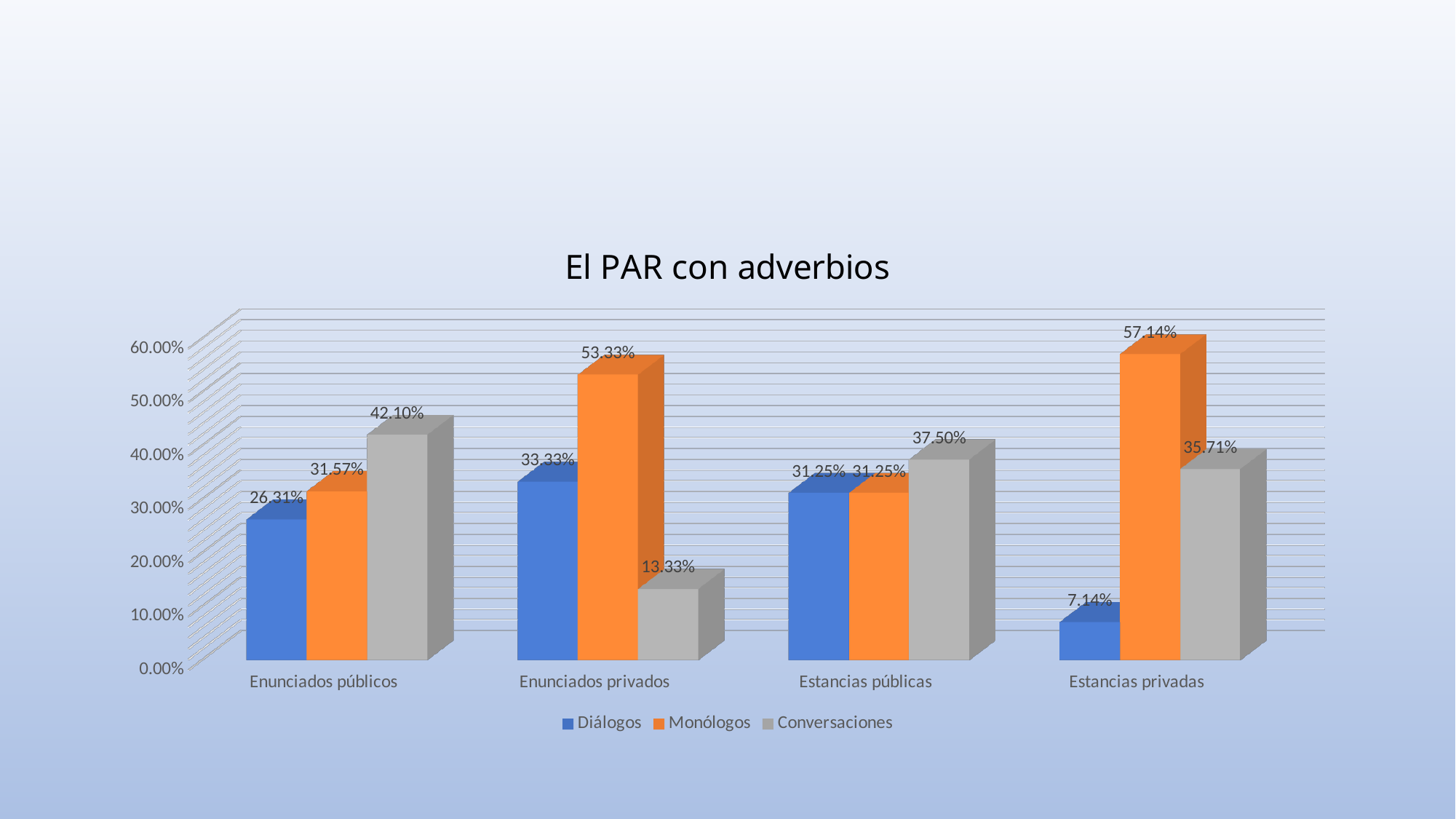
What is the difference between the Monólogos and Diálogos values in the Estancias privadas category? 50.00% Which category has the highest value for Monólogos? Estancias privadas What kind of chart is shown on the slide? Bar chart What is the value for Conversaciones in the Enunciados privados category? 13.33% Which category has the lowest value for Diálogos? Estancias privadas Which series is shown in orange? Monólogos How many series does the legend list? 3 Which is larger in the Enunciados públicos category, Diálogos or Conversaciones? Conversaciones How many categories are shown on the x axis? 4 What is the value for Monólogos in the Estancias privadas category? 57.14% What is the value for Diálogos in the Enunciados públicos category? 26.31% What is the title of the chart? El PAR con adverbios